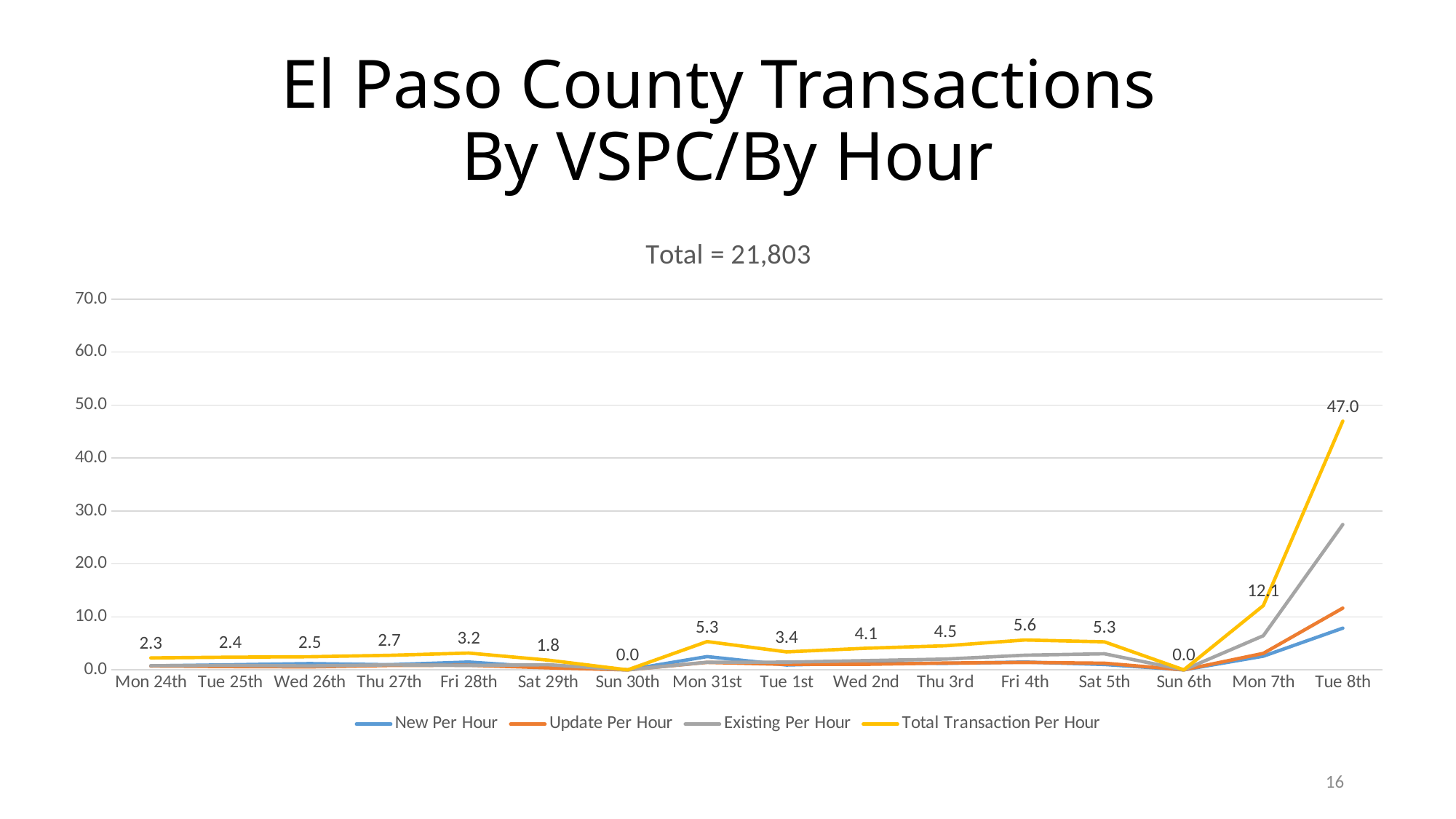
Which is larger, the Total Transaction Per Hour for Mon 31st or for Tue 1st? Mon 31st On which date is Total Transaction Per Hour highest? Tue 8th What is the difference in Total Transaction Per Hour between Tue 8th and Mon 7th? 34.9 What type of chart is shown on the slide? line chart Which series is drawn in yellow? Total Transaction Per Hour What is the chart's title? Total = 21,803 Is the Existing Per Hour value for Tue 8th greater or less than 20.0? greater What is the Total Transaction Per Hour value for Fri 4th? 5.6 How many dates are shown along the x axis? 16 What is the Total Transaction Per Hour value for Mon 7th? 12.1 How many series does the legend list? 4 What is the Total Transaction Per Hour value for Tue 8th? 47.0